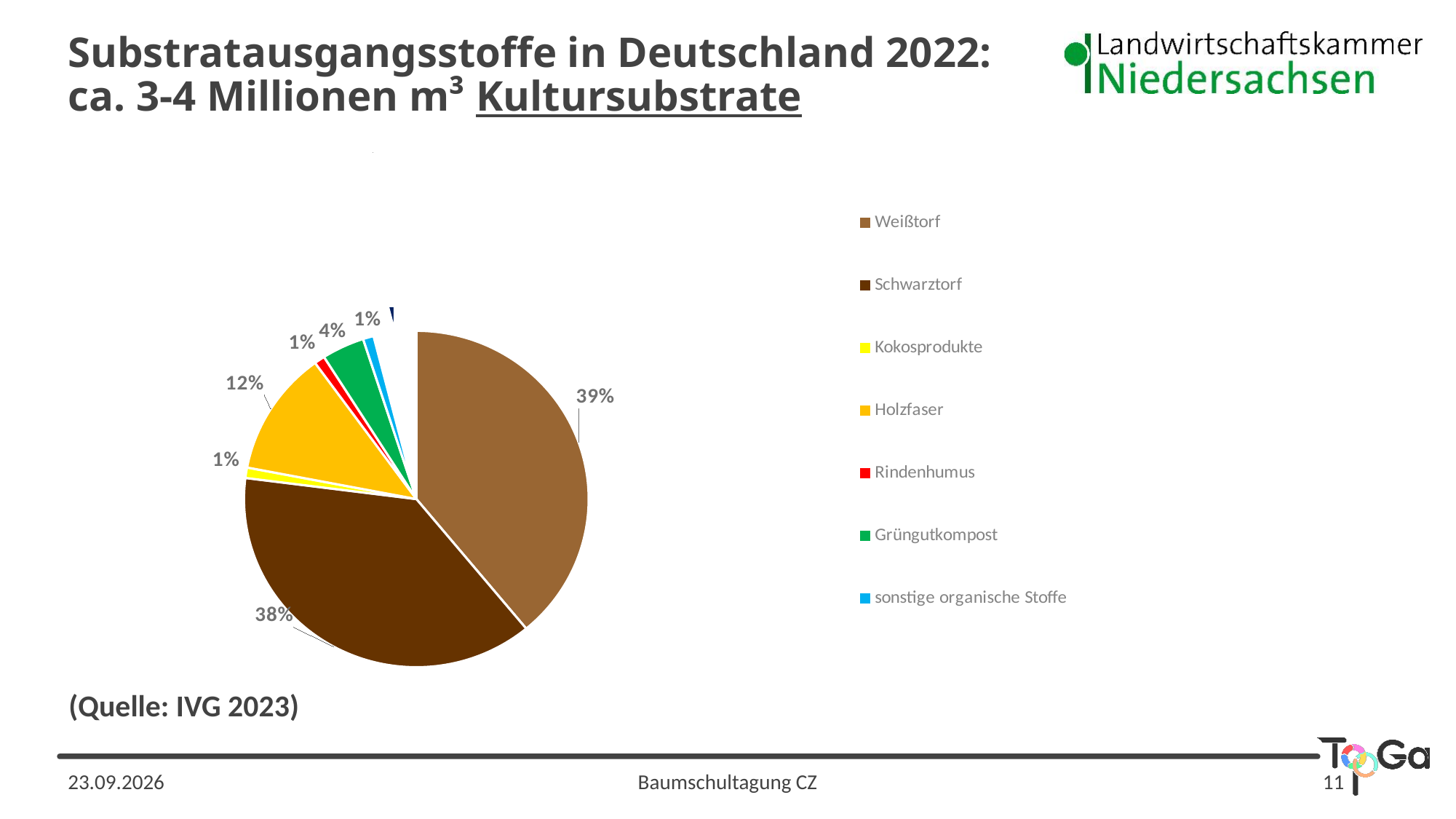
How many entries does the legend list? 7 What percentage is shown for Grüngutkompost? 4% What share of the pie does Schwarztorf account for? 38% What is the combined share of Weißtorf and Schwarztorf? 77% Which has a larger share, Holzfaser or Grüngutkompost? Holzfaser What percentage is shown for Holzfaser? 12% What is the difference in percentage points between Weißtorf and Schwarztorf? 1 Which category has the largest share of the pie? Weißtorf What share of the pie does Weißtorf account for? 39% What is the difference in percentage points between Holzfaser and Grüngutkompost? 8 What percentage is shown for Kokosprodukte? 1% What type of chart is shown on the slide? Pie chart